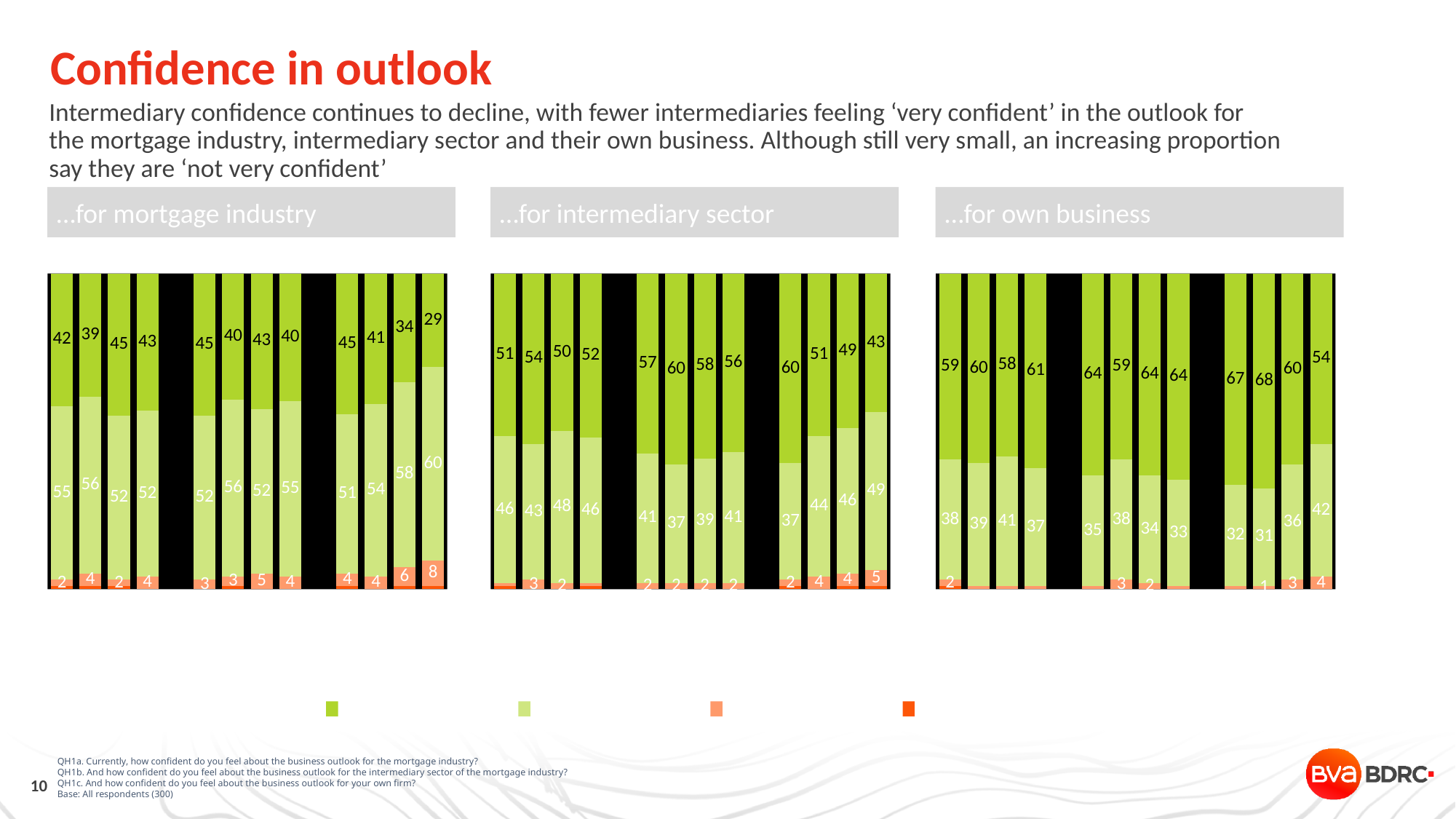
In the '...for mortgage industry' chart, what is the dark green value of the rightmost bar? 29 How many colour entries does the legend at the bottom of the slide show? 4 In the '...for mortgage industry' chart, do the dark green values rise or fall across the last four bars? Fall What kind of chart is used in the '...for mortgage industry' panel? Stacked bar chart In the '...for own business' chart, what is the light green value of the rightmost bar? 42 In the '...for intermediary sector' chart, what is the difference between the dark green value of the leftmost bar (51) and the rightmost bar (43)? 8 In the '...for own business' chart, what is the highest dark green value shown? 68 In the '...for mortgage industry' chart, what is the orange value of the rightmost bar? 8 How many bars are plotted in the '...for mortgage industry' chart? 12 In the '...for mortgage industry' chart, what is the lowest dark green value shown? 29 In the '...for intermediary sector' chart, is the dark green value of the rightmost bar larger or smaller than that of the leftmost bar? Smaller What is the title of the middle chart on the slide? ...for intermediary sector